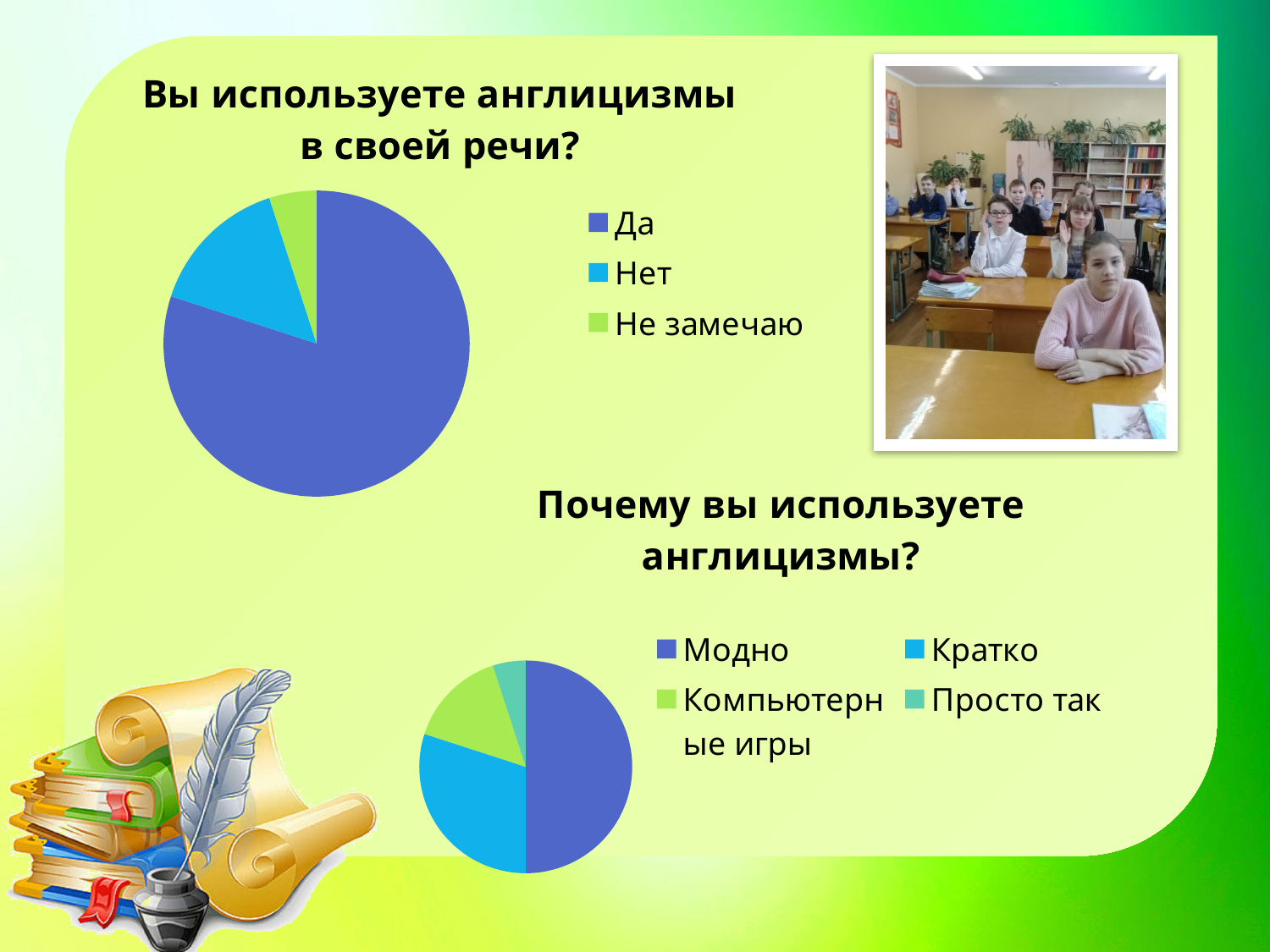
In the chart titled "Вы используете англицизмы в своей речи?", which category has the largest slice? Да In the chart titled "Почему вы используете англицизмы?", which category has the smallest slice? Просто так In the chart titled "Почему вы используете англицизмы?", which slice is larger: Кратко or Компьютерные игры? Кратко How many categories does the legend of the chart titled "Вы используете англицизмы в своей речи?" list? 3 What kind of chart is the chart titled "Почему вы используете англицизмы?"? pie chart In the chart titled "Вы используете англицизмы в своей речи?", which slice is larger: Нет or Не замечаю? Нет In the chart titled "Почему вы используете англицизмы?", which category has the largest slice? Модно What is the title of the pie chart at the bottom of the slide? Почему вы используете англицизмы? In the chart titled "Вы используете англицизмы в своей речи?", what colour is the slice for Да? blue What kind of chart is the chart titled "Вы используете англицизмы в своей речи?"? pie chart In the chart titled "Вы используете англицизмы в своей речи?", which category has the smallest slice? Не замечаю How many categories does the legend of the chart titled "Почему вы используете англицизмы?" list? 4